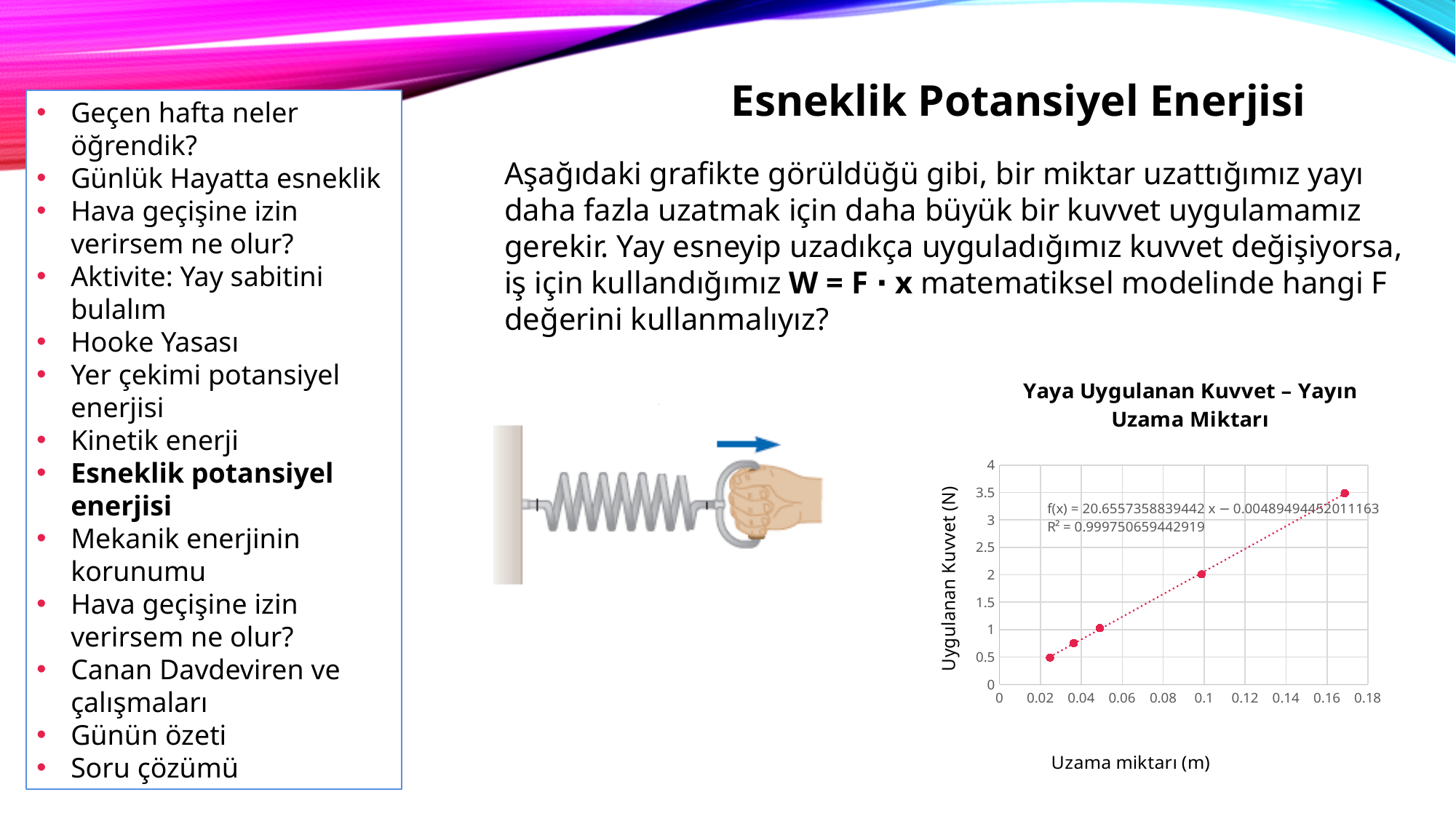
Is the force value for the point at an extension of about 0.1 m greater or less than 1.5? greater Is the force value for the point at the largest extension greater or less than 3? greater Is the force value for the point at the smallest extension greater or less than 1? less Do the plotted values rise or fall as the extension (Uzama miktarı) increases along the x axis? rise What is the title of the chart? Yaya Uygulanan Kuvvet – Yayın Uzama Miktarı What kind of chart is shown on the slide? scatter chart What is the maximum value shown on the y axis of the chart? 4 How many data points are plotted on the chart? 5 Which plotted point has the highest force value: the one at the largest extension or the one at the smallest extension? the one at the largest extension What is the R² value shown on the chart for the trendline? 0.999750659442919 What is the label of the y axis of the chart? Uygulanan Kuvvet (N)